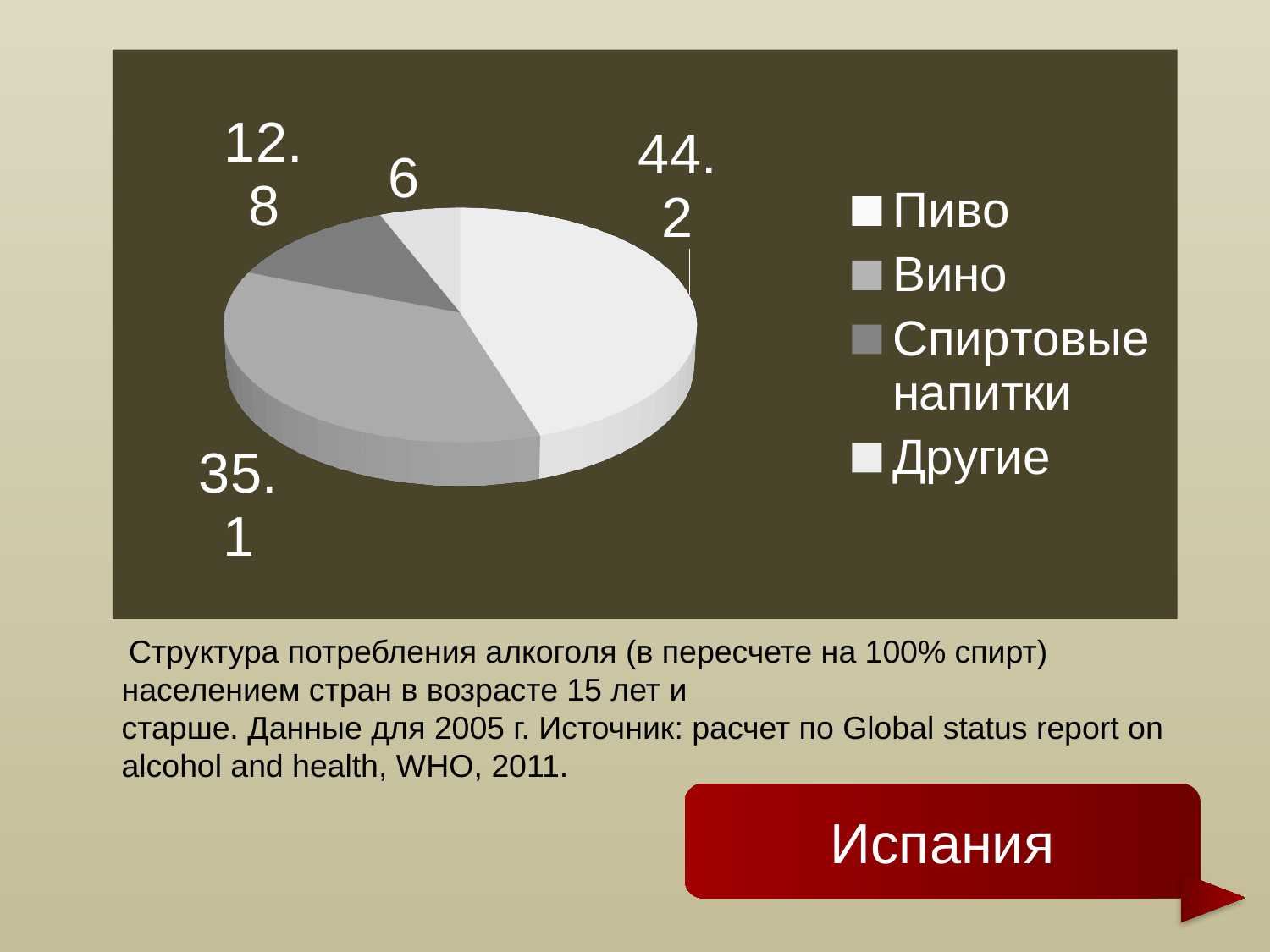
Which category has the largest slice? Пиво What type of chart is shown on the slide? pie chart What is the value for Спиртовые напитки? 12.8 Which is larger, the value for Вино or the value for Спиртовые напитки? Вино Which category has the smallest slice? Другие What is the value for Вино? 35.1 Which country is named in the red box below the chart? Испания What is the difference between the values for Пиво and Вино? 9.1 How many categories does the pie chart have? 4 What is the value for Пиво? 44.2 What is the difference between the values for Спиртовые напитки and Другие? 6.8 What is the value for Другие? 6